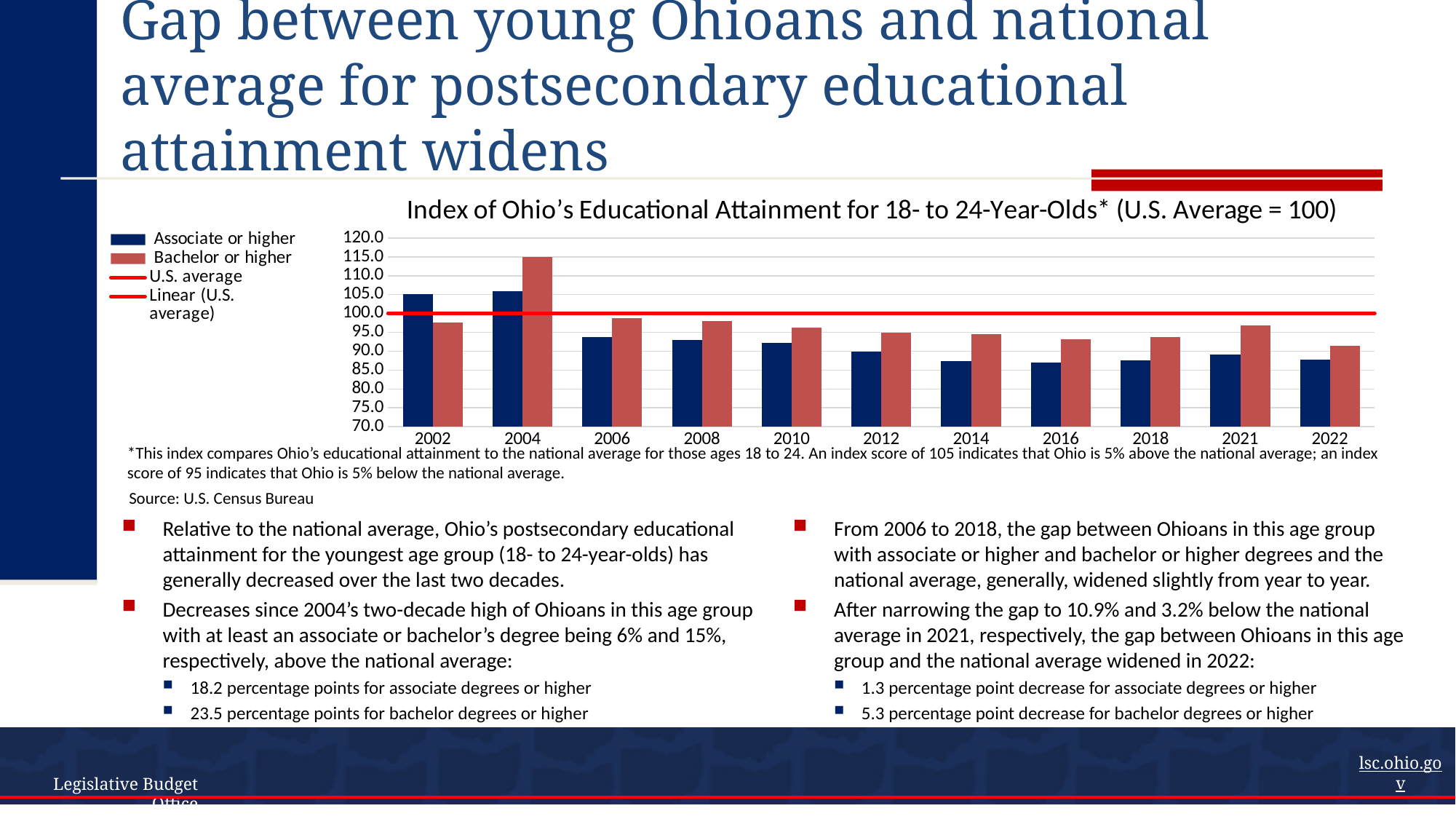
In 2004, which is larger: the Associate or higher index or the Bachelor or higher index? Bachelor or higher How many years are shown along the x axis of the chart? 11 Does the Associate or higher index generally rise or fall from 2002 to 2022? fall In which year is the Bachelor or higher index lowest? 2022 How many entries does the chart legend list? 4 Is the Associate or higher value for 2002 greater or less than 100? greater What is the Bachelor or higher index value for 2004? 115.0 In which year is the Bachelor or higher index highest? 2004 At what index value is the U.S. average line drawn on the chart? 100.0 Is the Associate or higher value for 2016 greater or less than 90? less What kind of chart is shown on the slide? bar chart Is the Bachelor or higher value for 2022 greater or less than 95? less